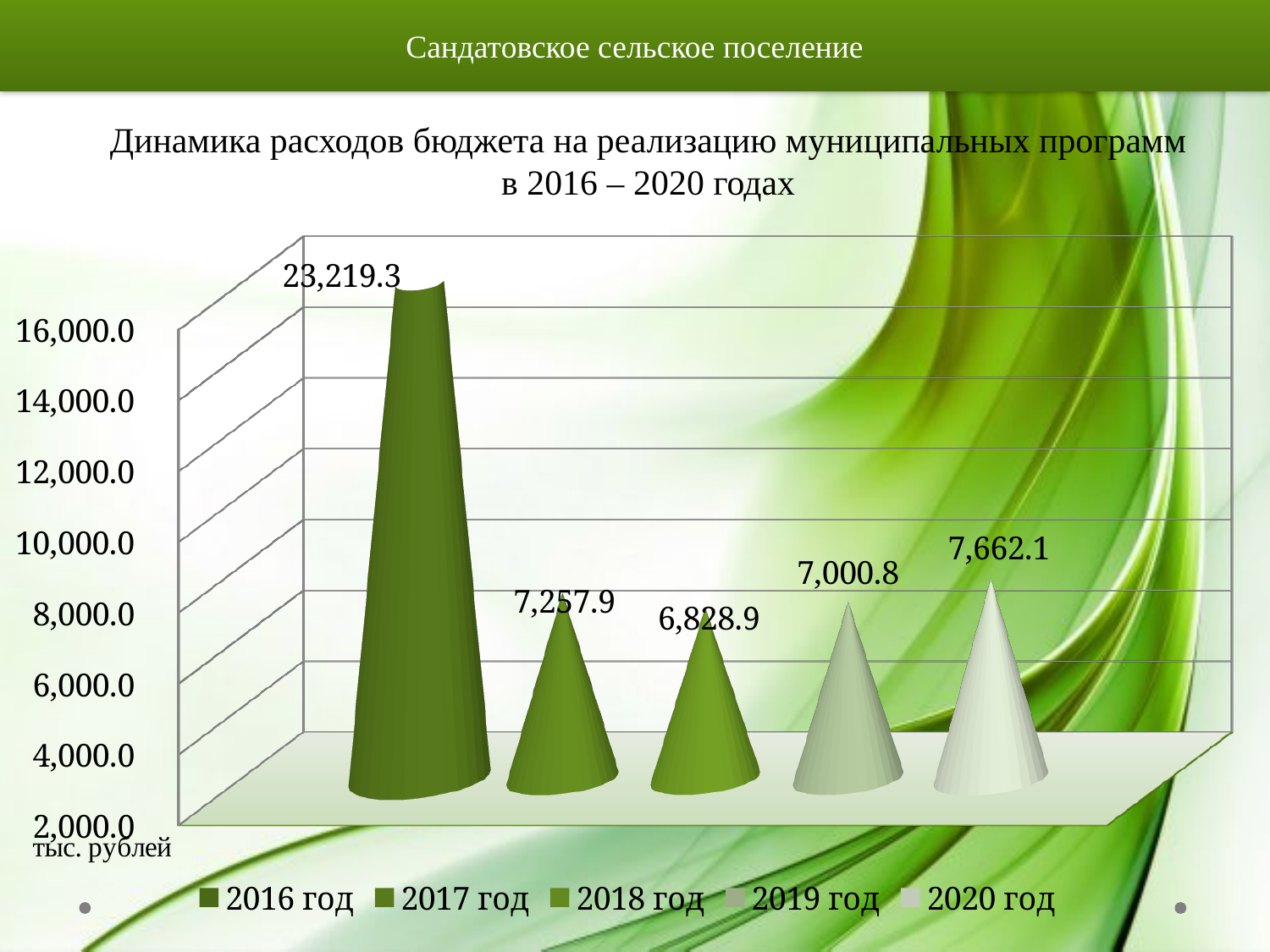
What kind of chart is shown on the slide? bar chart What is the value for 2016 год? 23,219.3 What is the difference between the values for 2020 год and 2019 год? 661.3 Which year has the lowest value? 2018 год What is the value for 2018 год? 6,828.9 What is the value for 2020 год? 7,662.1 What unit is indicated for the values on the chart? тыс. рублей Which is larger, the value for 2017 год or the value for 2019 год? 2017 год What is the difference between the values for 2016 год and 2017 год? 15,961.4 Is the value for 2016 год greater or less than 16,000.0? greater How many series does the legend list? 5 Which year has the highest value? 2016 год